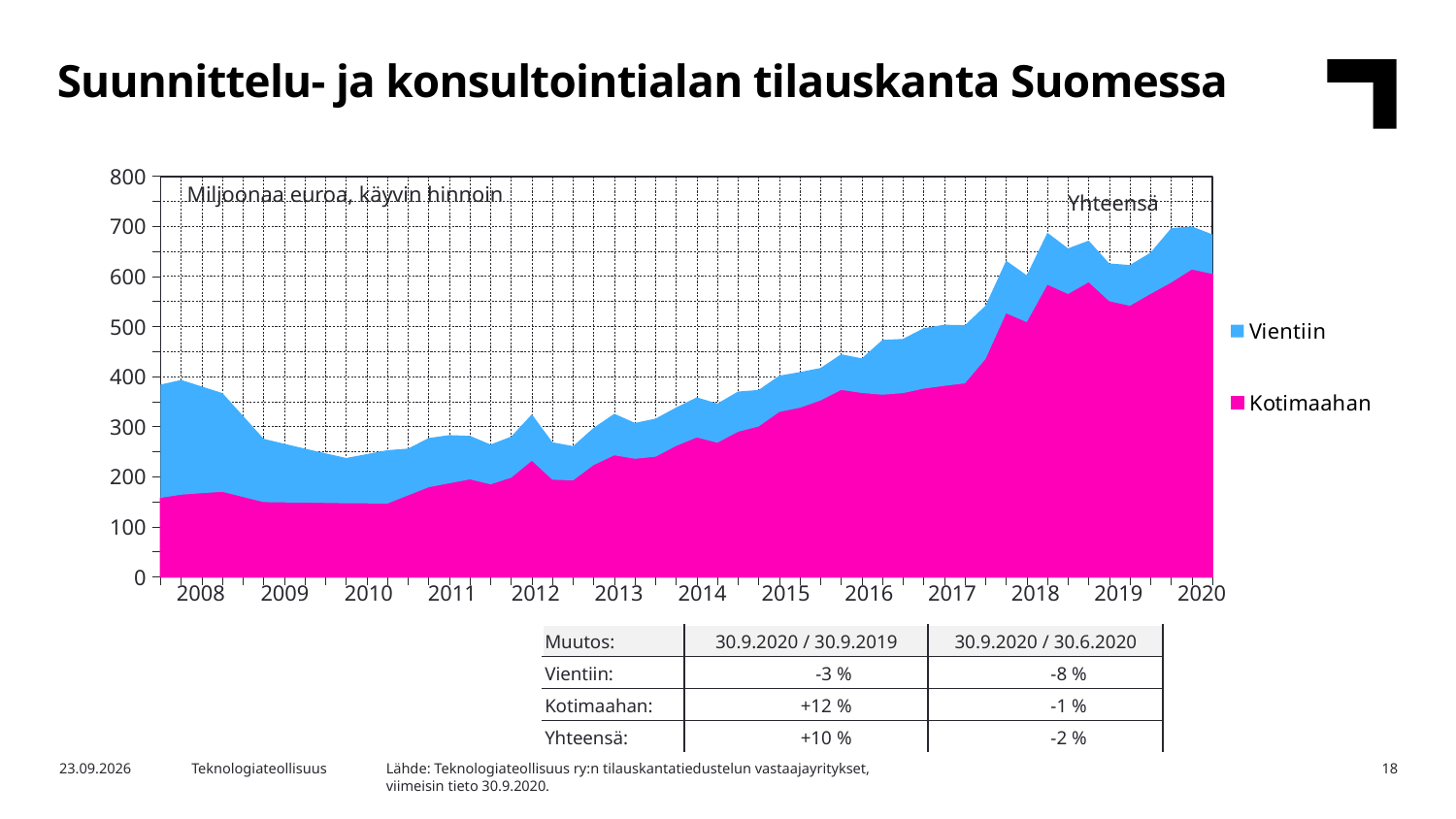
What kind of chart is shown on the slide? Stacked area chart Is the total (Yhteensä) value at the start of 2016 greater or less than 400? greater Is the value for Kotimaahan at the start of 2018 greater or less than 500? greater In the table below the chart, what is the change for Vientiin between 30.9.2019 and 30.9.2020? -3 % Is the total (Yhteensä) value at the end of the series in 2020 greater or less than 600? greater Which two series are listed in the chart legend? Vientiin and Kotimaahan How many years are labelled on the x axis of the chart? 13 What unit is stated in the label inside the chart area? Miljoonaa euroa, käyvin hinnoin How many series does the chart legend list? 2 Does the Kotimaahan series generally rise or fall from 2008 to 2020? rise